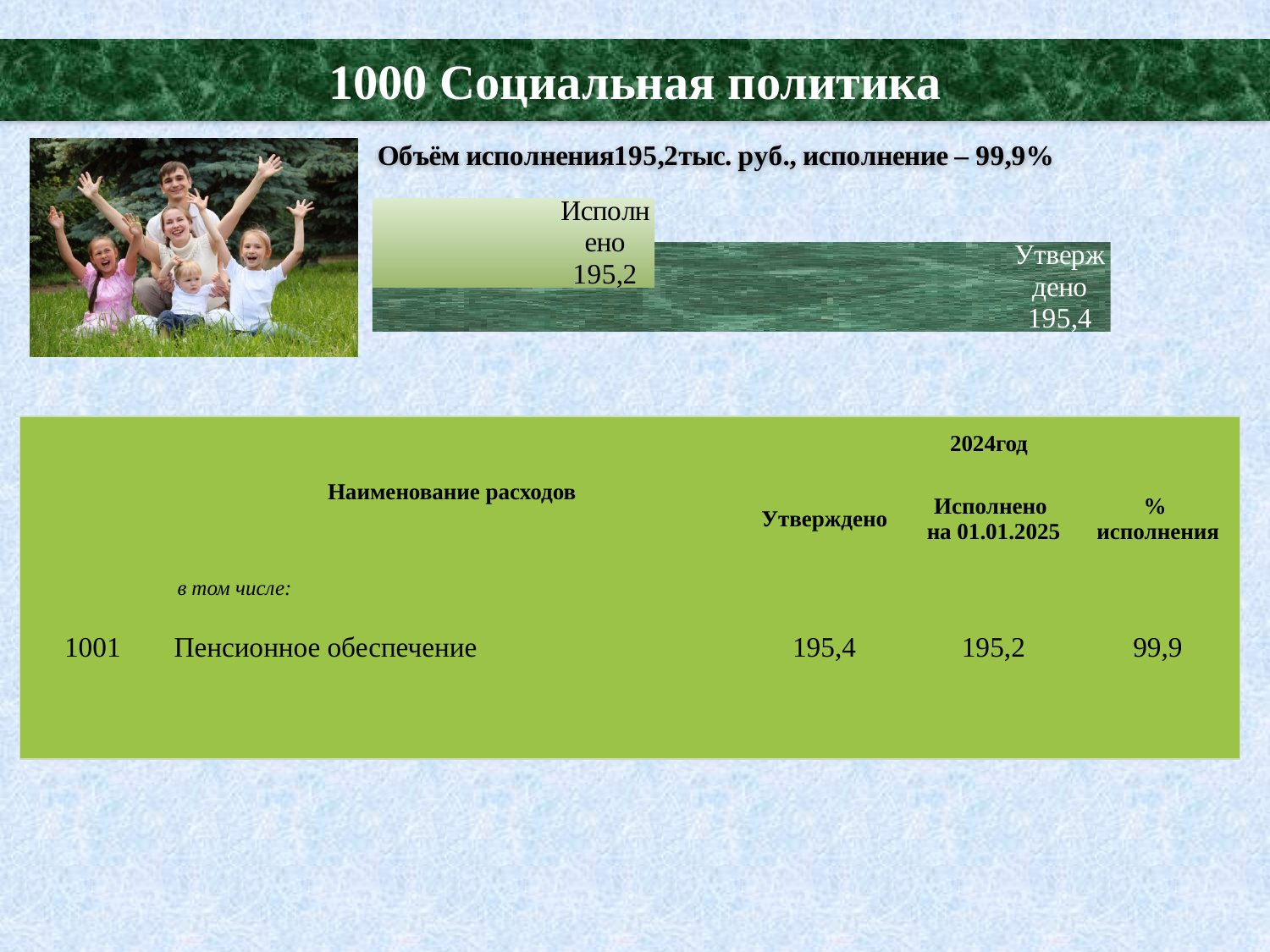
Is the value for Утверждено larger or smaller than the value for Исполнено? larger Which bar in the chart has the higher value? Утверждено What kind of chart is shown on the slide? bar chart Which bar in the chart has the lower value? Исполнено How many bars are plotted in the chart? 2 What is the value shown for Исполнено in the chart? 195,2 What is the difference between the Утверждено and Исполнено values in the chart? 0,2 What is the value shown for Утверждено in the chart? 195,4 What are the labels of the two bars in the chart? Исполнено and Утверждено Are the bars in the chart oriented horizontally or vertically? horizontally